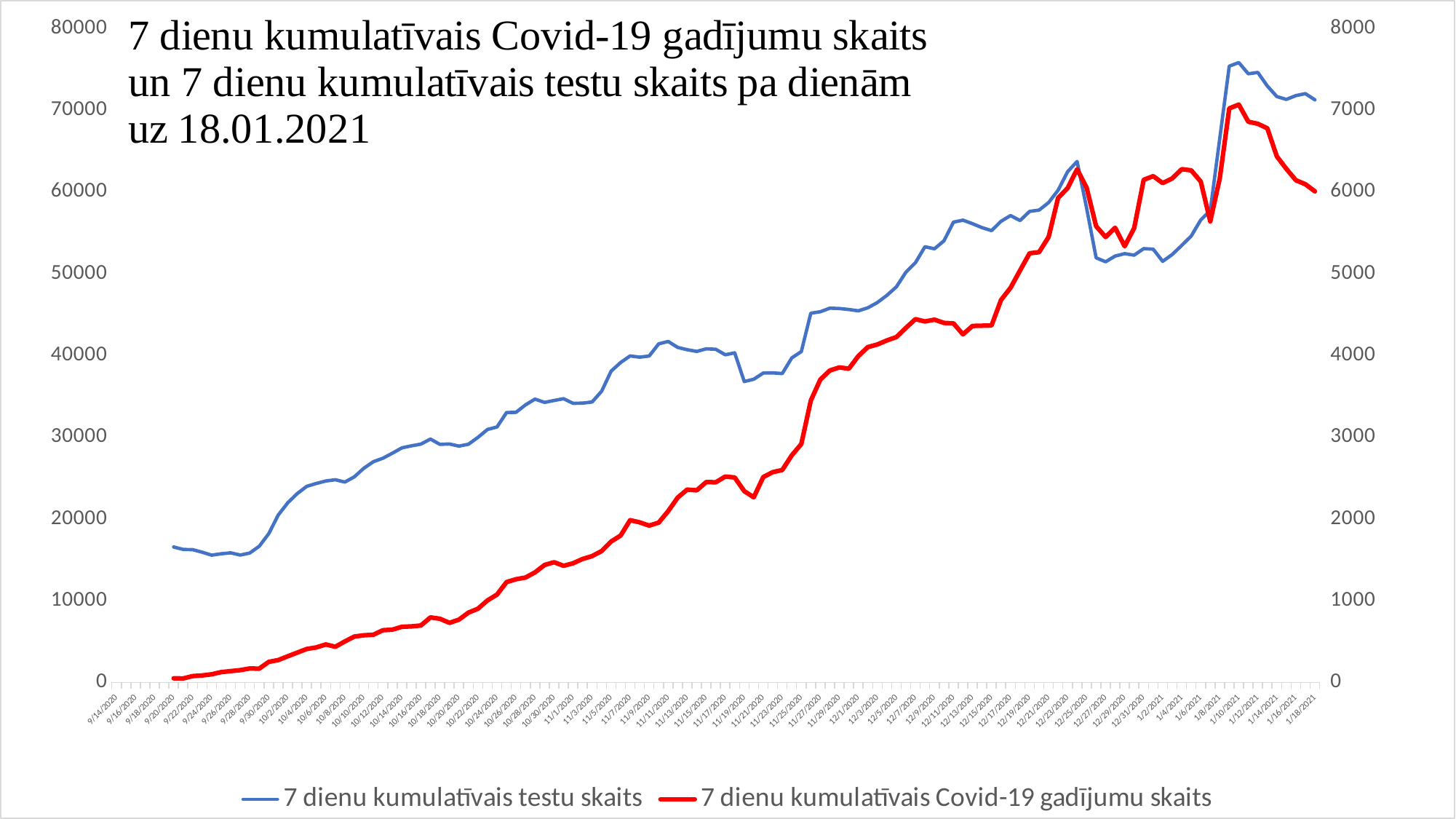
Is the value of '7 dienu kumulatīvais testu skaits' at the start of the series (around 9/20/2020) greater or less than 20000 on the left axis? less Which colour is used for the series '7 dienu kumulatīvais Covid-19 gadījumu skaits'? Red Is the value of '7 dienu kumulatīvais Covid-19 gadījumu skaits' at the start of the series (around 9/20/2020) greater or less than 1000 on the right axis? less What kind of chart is shown on the slide? Line chart How many series does the legend list? 2 What is the title of the chart? 7 dienu kumulatīvais Covid-19 gadījumu skaits un 7 dienu kumulatīvais testu skaits pa dienām uz 18.01.2021 Is the peak value of '7 dienu kumulatīvais testu skaits' (around 1/10/2021) greater or less than 70000 on the left axis? greater Does the '7 dienu kumulatīvais testu skaits' line generally rise or fall from September 2020 to January 2021? Rise Does the '7 dienu kumulatīvais Covid-19 gadījumu skaits' line generally rise or fall over the period shown? Rise What is the maximum value shown on the right-hand vertical axis? 8000